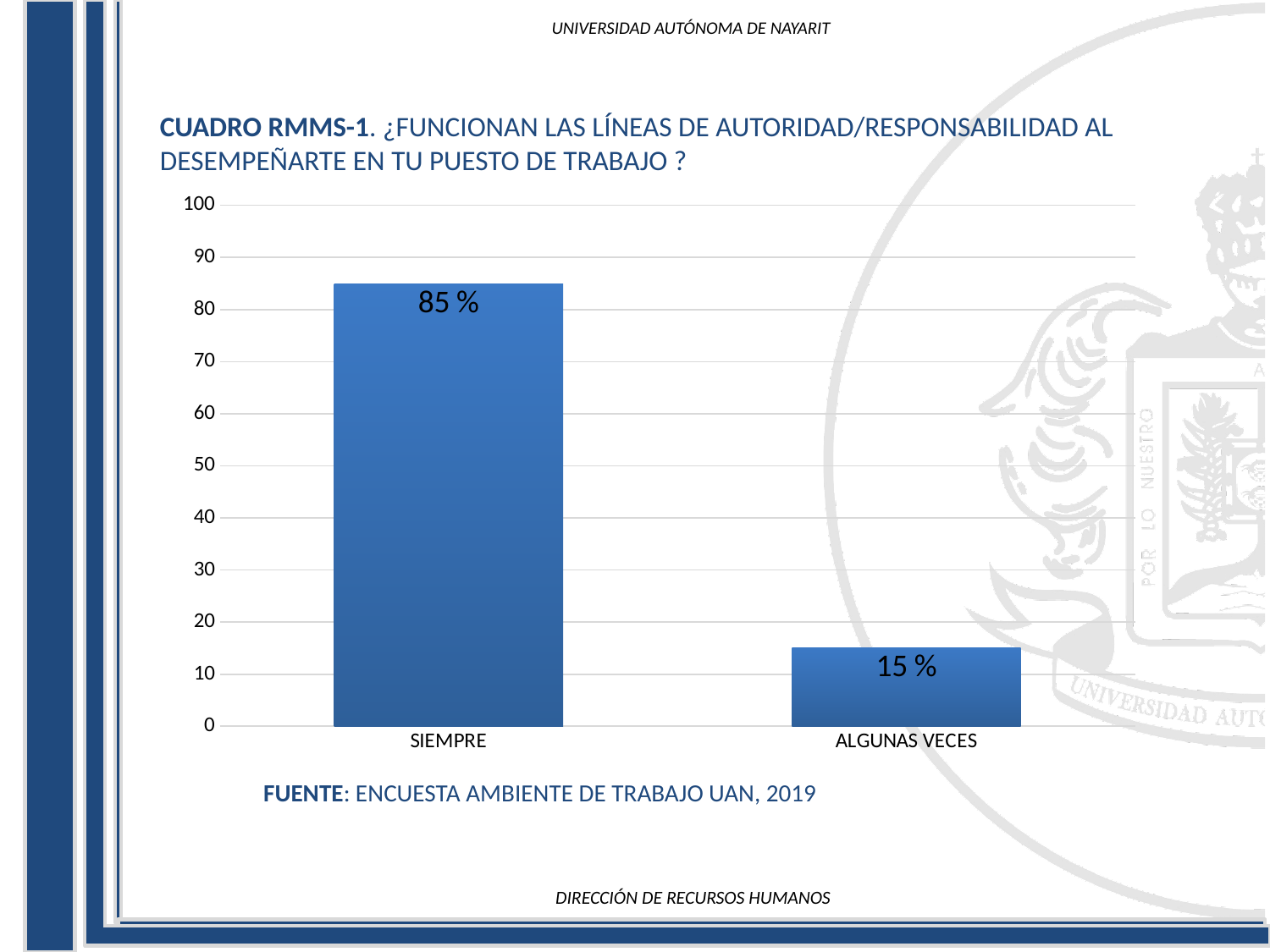
Is the value for ALGUNAS VECES greater or less than 20? less What is the value for ALGUNAS VECES? 15 % What is the value for SIEMPRE? 85 % Which is larger, the value for SIEMPRE or the value for ALGUNAS VECES? SIEMPRE What is the source cited below the chart? ENCUESTA AMBIENTE DE TRABAJO UAN, 2019 Which category has the lowest value? ALGUNAS VECES How many categories are shown on the x axis? 2 Which category has the highest value? SIEMPRE What is the highest value shown on the y axis? 100 What kind of chart is shown on the slide? bar chart Is the value for SIEMPRE greater or less than 80? greater What is the difference between the values for SIEMPRE and ALGUNAS VECES? 70 %